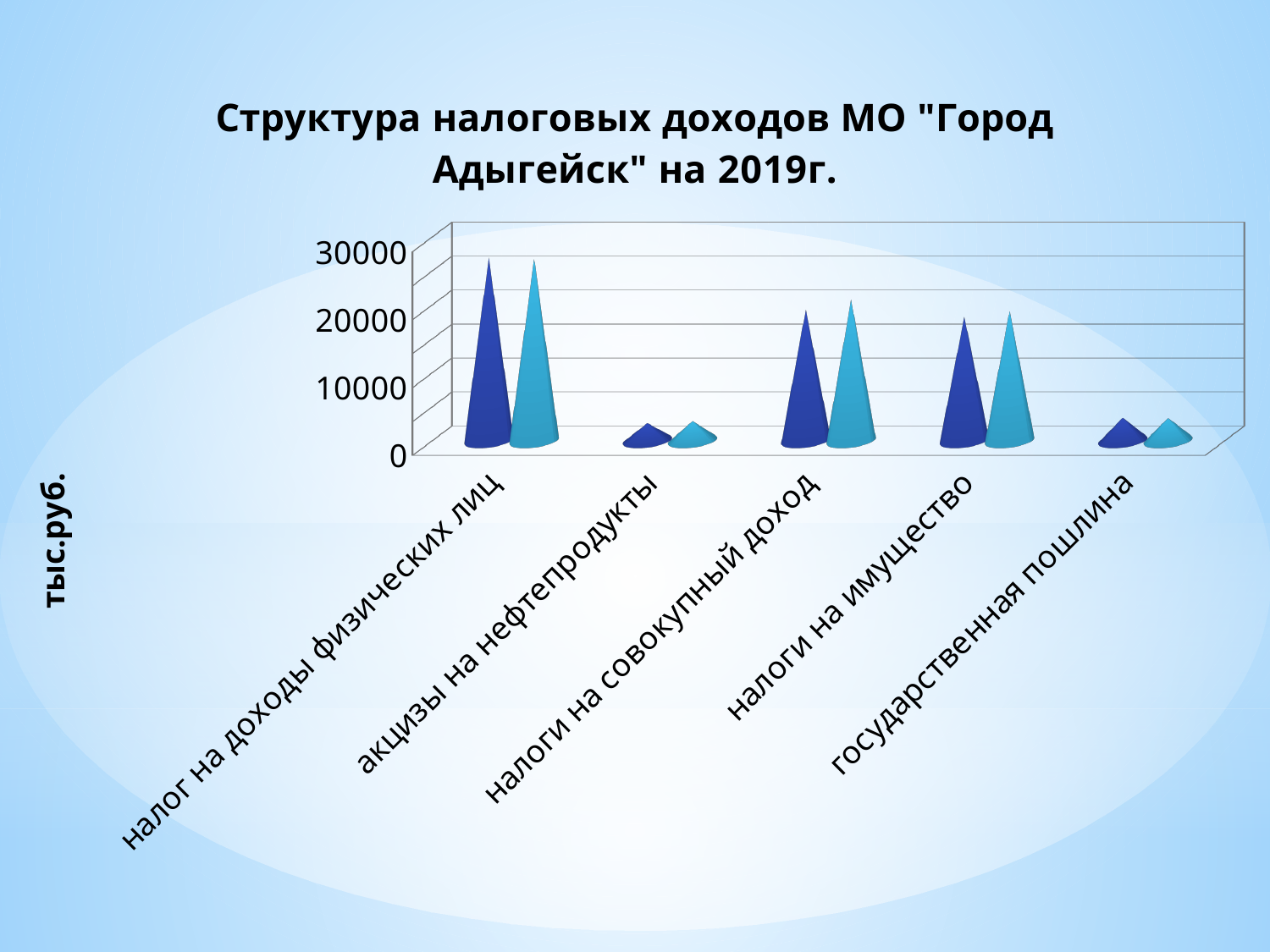
Which category has the highest values in the chart? налог на доходы физических лиц Is the light blue value for налоги на совокупный доход greater or less than 10000? greater Is the light blue value for государственная пошлина greater or less than 10000? less What kind of chart is shown on the slide? bar chart What is the title of the chart? Структура налоговых доходов МО "Город Адыгейск" на 2019г. How many categories are shown on the x axis of the chart? 5 Which is larger in the chart: the value for налог на доходы физических лиц or the value for акцизы на нефтепродукты? налог на доходы физических лиц Is the dark blue value for налоги на имущество greater or less than 10000? greater Which is larger in the chart: the value for налоги на совокупный доход or the value for государственная пошлина? налоги на совокупный доход What unit is given on the vertical axis label of the chart? тыс.руб.